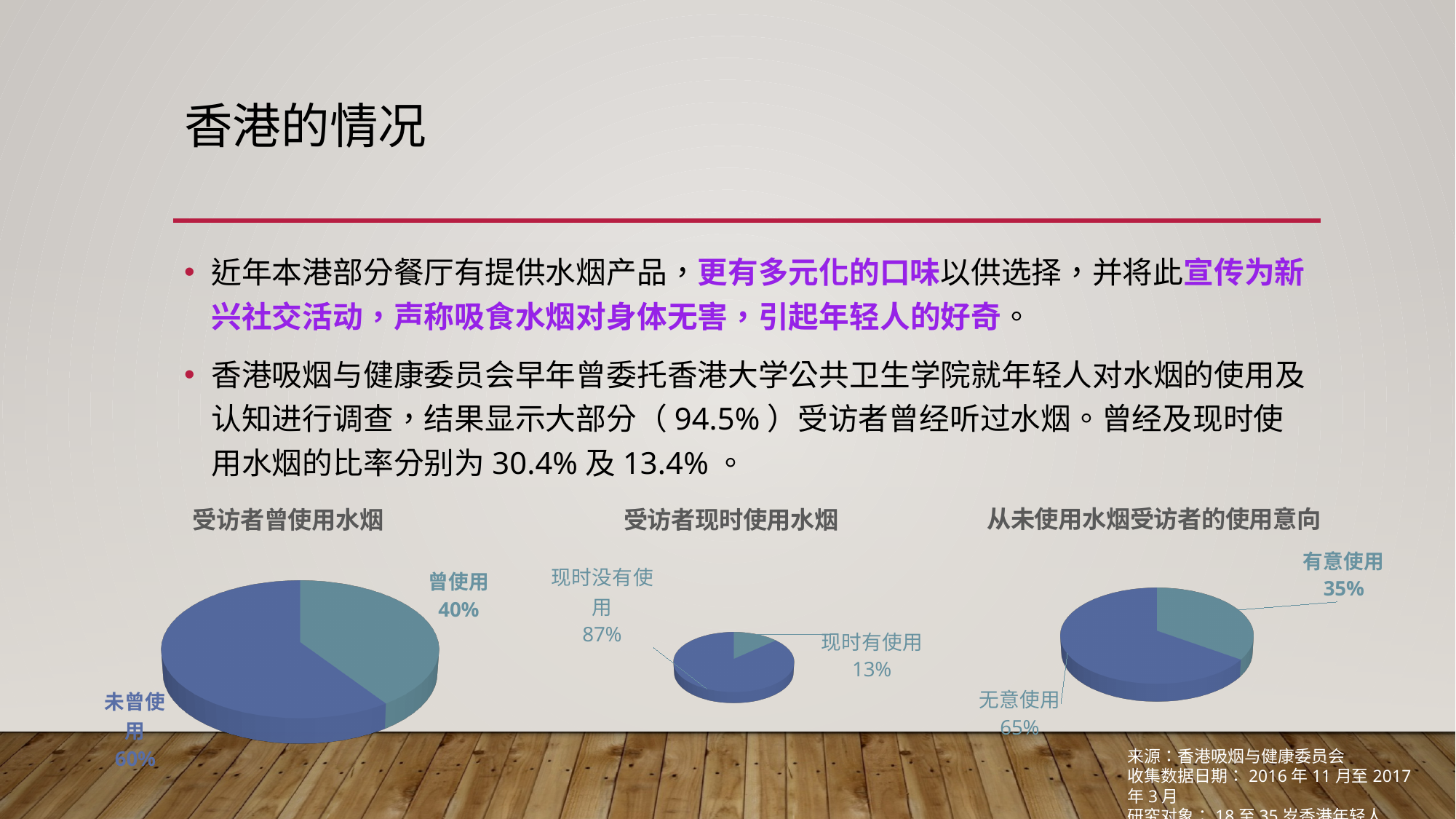
在「受访者曾使用水烟」图表中，哪一类别的比例最大？ 未曾使用 在「受访者现时使用水烟」图表中，「现时没有使用」与「现时有使用」的比例相差多少？ 74% 在「从未使用水烟受访者的使用意向」图表中，「有意使用」的比例是多少？ 35% 在「从未使用水烟受访者的使用意向」图表中，「无意使用」的比例是多少？ 65% 在「受访者现时使用水烟」图表中，「现时有使用」的比例是多少？ 13% 在「受访者现时使用水烟」图表中，哪一类别的比例最小？ 现时有使用 在「受访者现时使用水烟」图表中，「现时没有使用」的比例是多少？ 87% 在「从未使用水烟受访者的使用意向」图表中，「无意使用」与「有意使用」的比例相差多少？ 30% 在「受访者曾使用水烟」图表中，「曾使用」的比例是多少？ 40% 在「受访者曾使用水烟」图表中，「未曾使用」的比例是多少？ 60% 「受访者曾使用水烟」图表是什么类型的图表？ 饼图 这张幻灯片上共有多少个图表？ 3